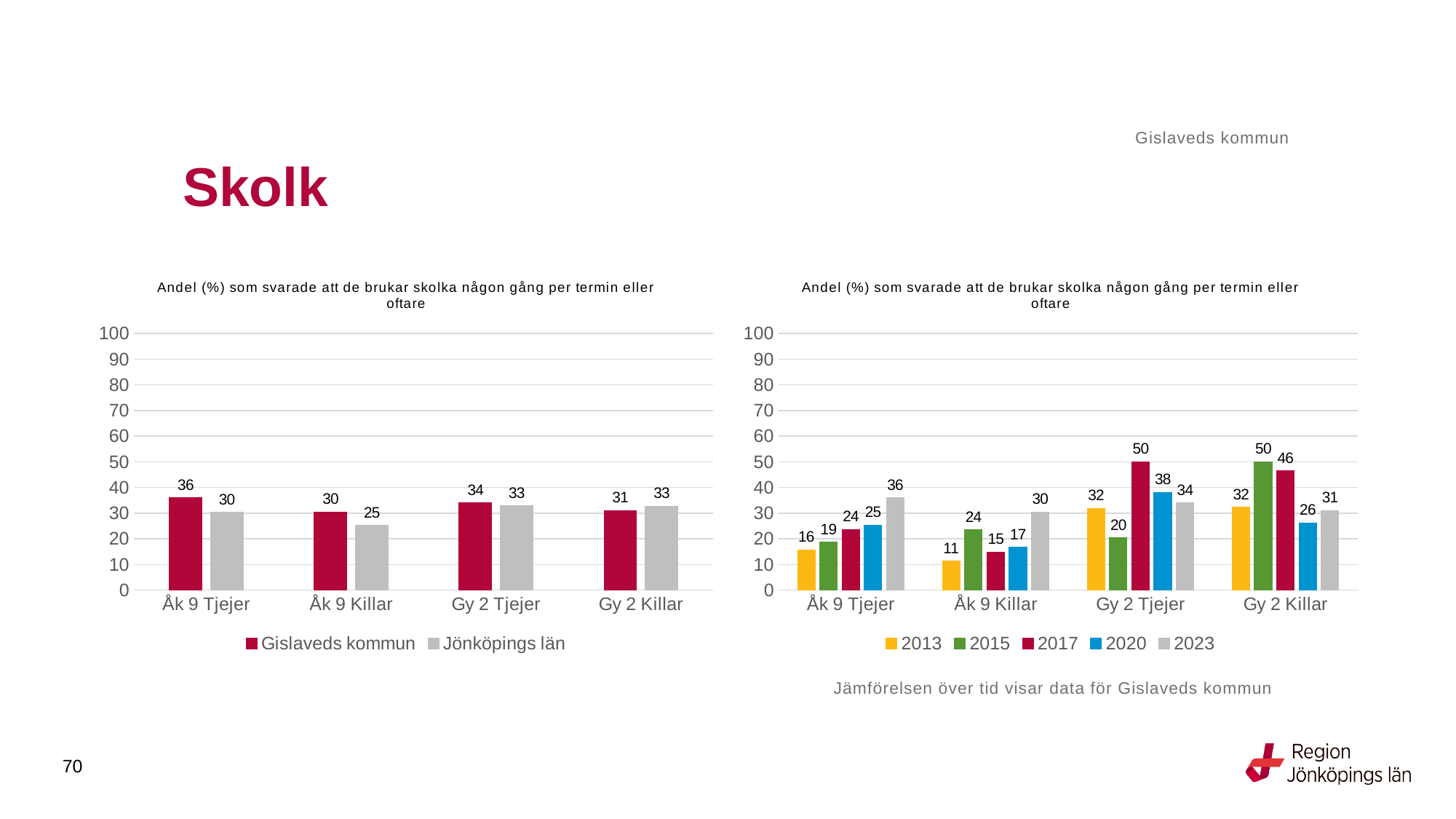
How many series does the legend of the right chart list? 5 In the right chart, does the value for Åk 9 Tjejer rise or fall from 2013 to 2023? rise In the right chart, which year has the lowest value for Gy 2 Killar? 2020 In the right chart, what is the value for 2013 for Åk 9 Killar? 11 In the left chart, what is the difference between Gislaveds kommun and Jönköpings län for Åk 9 Tjejer? 6 In the left chart, what is the value for Jönköpings län for Åk 9 Killar? 25 In the right chart, what is the value for 2017 for Gy 2 Tjejer? 50 How many series does the legend of the left chart list? 2 In the left chart, what is the value for Gislaveds kommun for Åk 9 Tjejer? 36 In the left chart, which category has the highest value for Gislaveds kommun? Åk 9 Tjejer In the left chart, which is larger for Gy 2 Killar: Gislaveds kommun or Jönköpings län? Jönköpings län What kind of chart is the right chart? bar chart